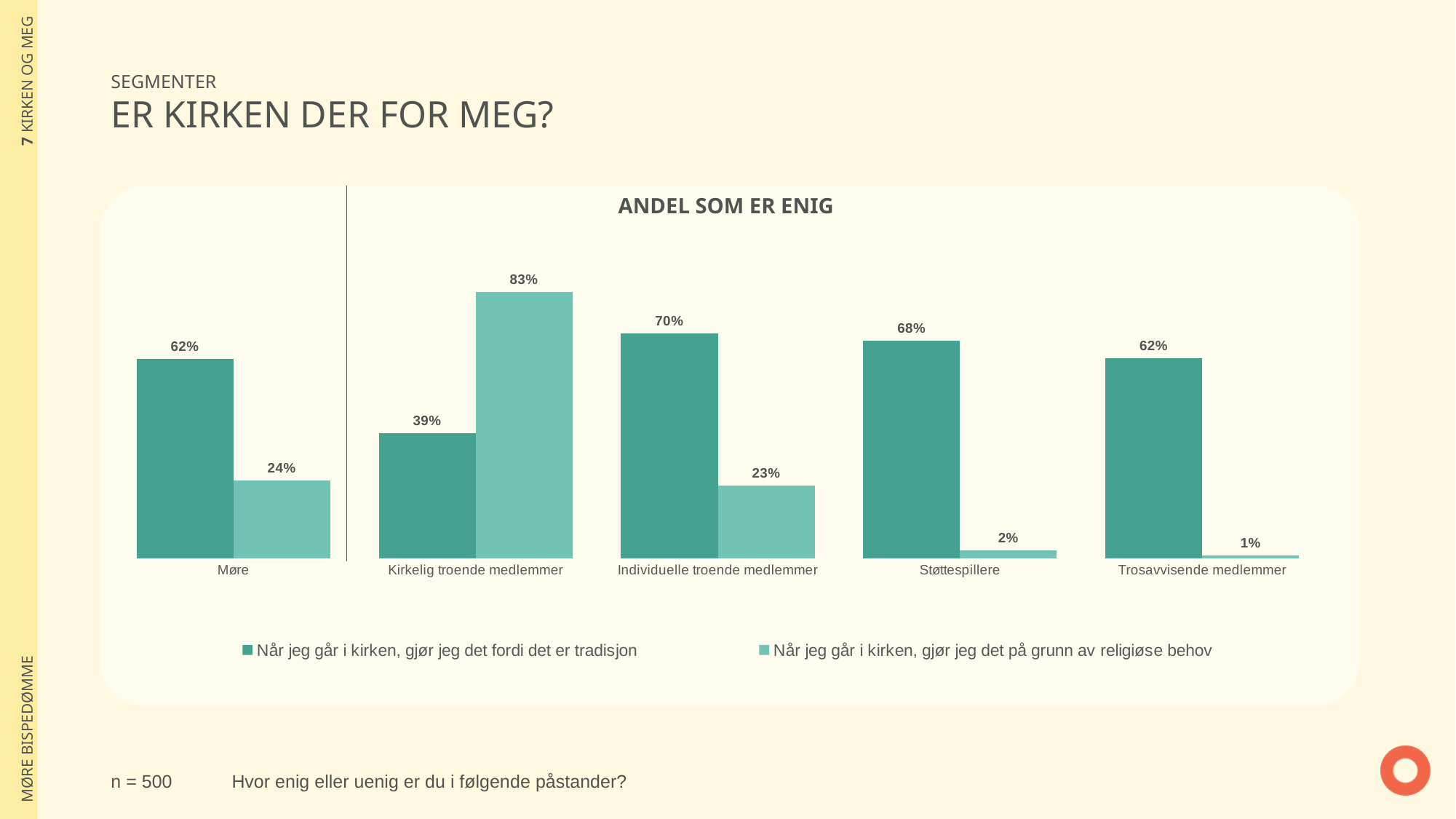
What kind of chart is shown on the slide? Bar chart What is the value for Trosavvisende medlemmer for the series 'Når jeg går i kirken, gjør jeg det fordi det er tradisjon'? 62% What is the value for Støttespillere for the series 'Når jeg går i kirken, gjør jeg det på grunn av religiøse behov'? 2% What is the value for Kirkelig troende medlemmer for the series 'Når jeg går i kirken, gjør jeg det på grunn av religiøse behov'? 83% How many categories are shown on the x axis? 5 Which category has the lowest value for the series 'Når jeg går i kirken, gjør jeg det på grunn av religiøse behov'? Trosavvisende medlemmer What is the value for Møre for the series 'Når jeg går i kirken, gjør jeg det fordi det er tradisjon'? 62% How many series does the legend list? 2 Which category has the highest value for the series 'Når jeg går i kirken, gjør jeg det fordi det er tradisjon'? Individuelle troende medlemmer For Individuelle troende medlemmer, which series has the larger value: 'fordi det er tradisjon' or 'på grunn av religiøse behov'? Når jeg går i kirken, gjør jeg det fordi det er tradisjon What is the difference between the two series values for Kirkelig troende medlemmer? 44 percentage points What is the title of the chart? ANDEL SOM ER ENIG